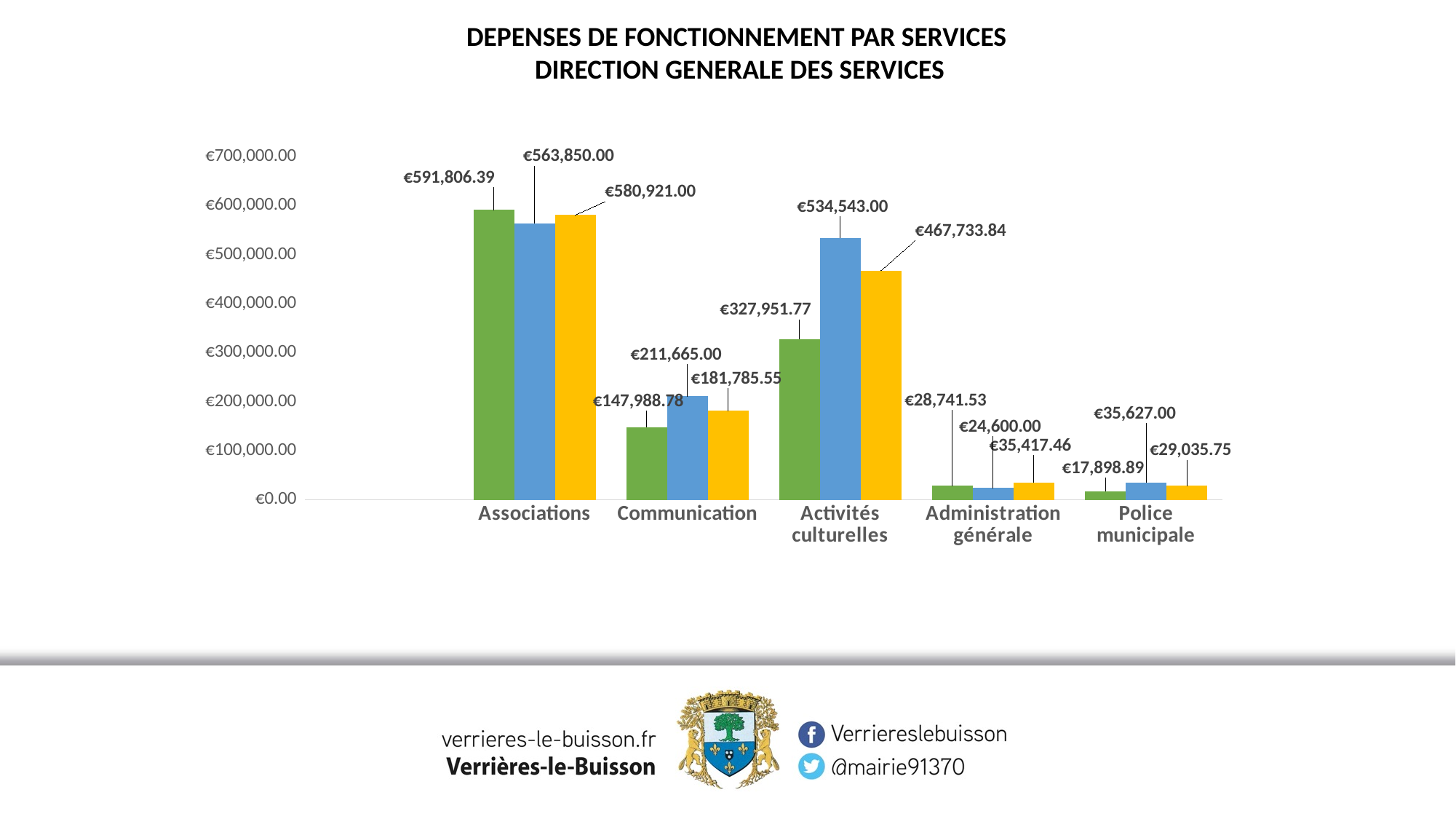
What kind of chart is shown on the slide? bar chart How many categories are shown on the x axis? 5 What is the value of the green bar for Police municipale? €17,898.89 What is the value of the blue bar for Activités culturelles? €534,543.00 For Activités culturelles, which is larger: the blue bar or the yellow bar? the blue bar What is the difference between the blue bar and the green bar for Communication? €63,676.22 What is the value of the green bar for Associations? €591,806.39 Which category has the highest green bar? Associations What is the title of the chart? DEPENSES DE FONCTIONNEMENT PAR SERVICES DIRECTION GENERALE DES SERVICES What is the value of the yellow bar for Communication? €181,785.55 Is the value of the yellow bar for Activités culturelles greater or less than €400,000.00? greater Which category has the lowest blue bar? Administration générale